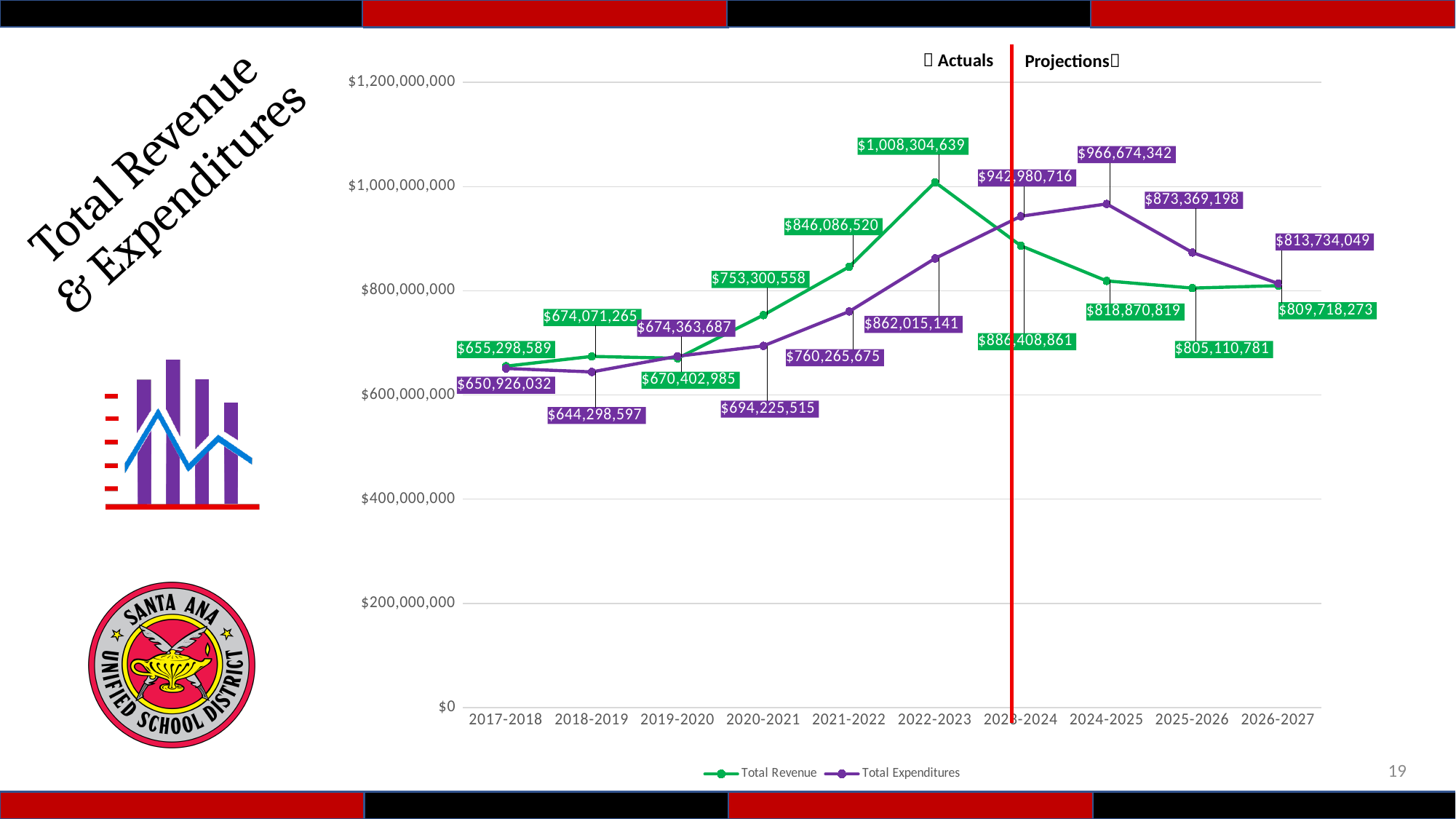
Is the Total Revenue for 2022-2023 greater or less than $1,000,000,000? greater What is the Total Revenue for 2022-2023? $1,008,304,639 What is the difference between Total Revenue and Total Expenditures in 2022-2023? $146,289,498 In which year is Total Revenue highest? 2022-2023 Does Total Revenue rise or fall from 2017-2018 to 2022-2023? Rise What is the Total Revenue for 2026-2027? $809,718,273 How many series does the legend list? 2 What is the Total Expenditures value for 2024-2025? $966,674,342 In which year is Total Expenditures lowest? 2018-2019 How many fiscal years are plotted along the x axis? 10 What kind of chart is shown on the slide? Line chart In 2025-2026, which is larger: Total Revenue or Total Expenditures? Total Expenditures